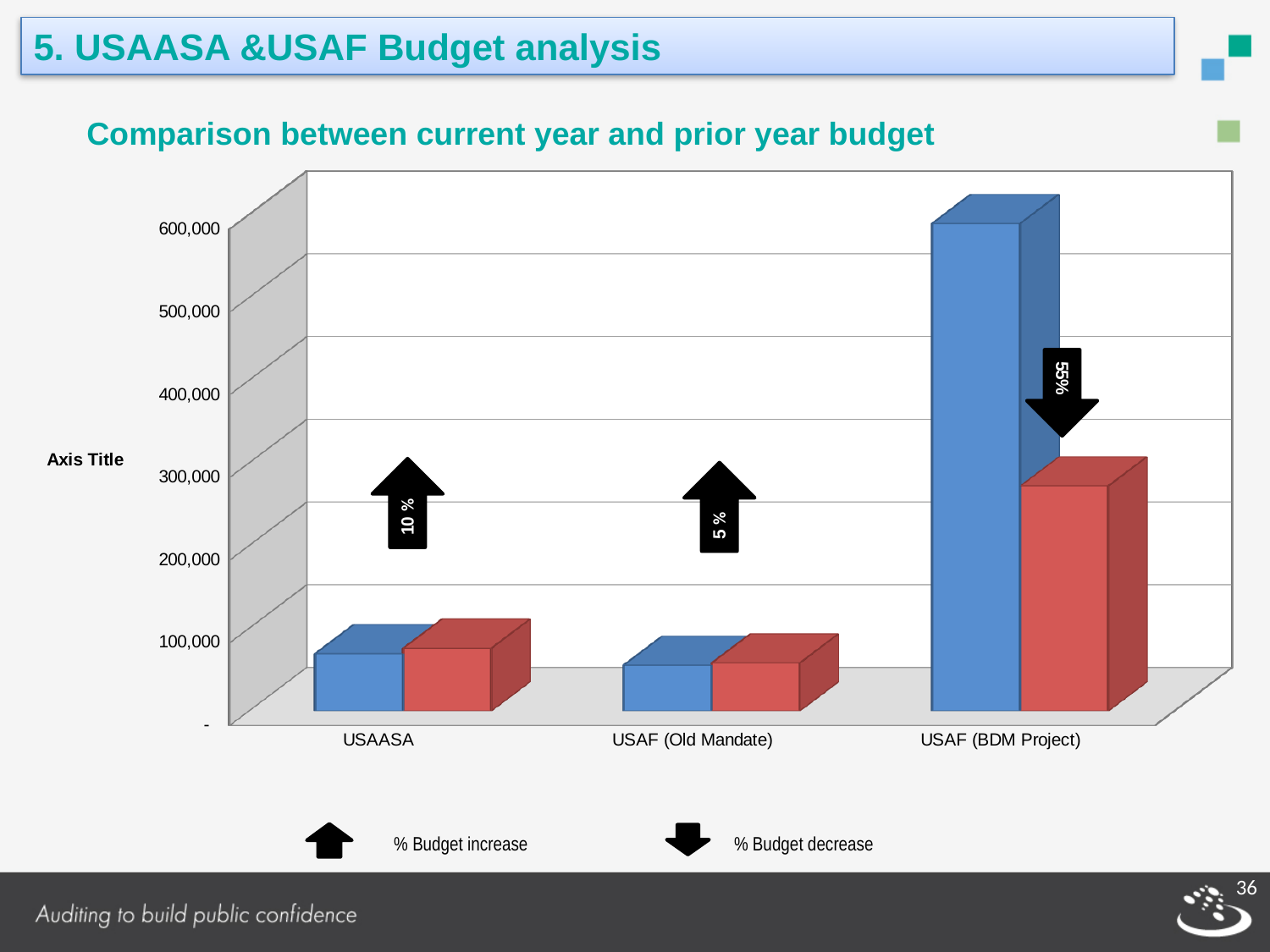
What percentage budget decrease is labelled on the arrow for USAF (BDM Project)? 55% How many categories are shown on the x axis of the chart? 3 Is the value of the red bar for USAF (Old Mandate) greater or less than 100,000? less What is the title of the chart on the slide? Comparison between current year and prior year budget Is the value of the blue bar for USAF (BDM Project) greater or less than 500,000? greater What kind of chart is shown on the slide? bar chart For USAF (BDM Project), which bar is larger, the blue bar or the red bar? the blue bar Is the value of the blue bar for USAASA greater or less than 100,000? less What percentage budget change is labelled on the arrow above USAF (Old Mandate)? 5 % What percentage budget change is labelled on the arrow above USAASA? 10 % Which category has the highest bar in the chart? USAF (BDM Project)